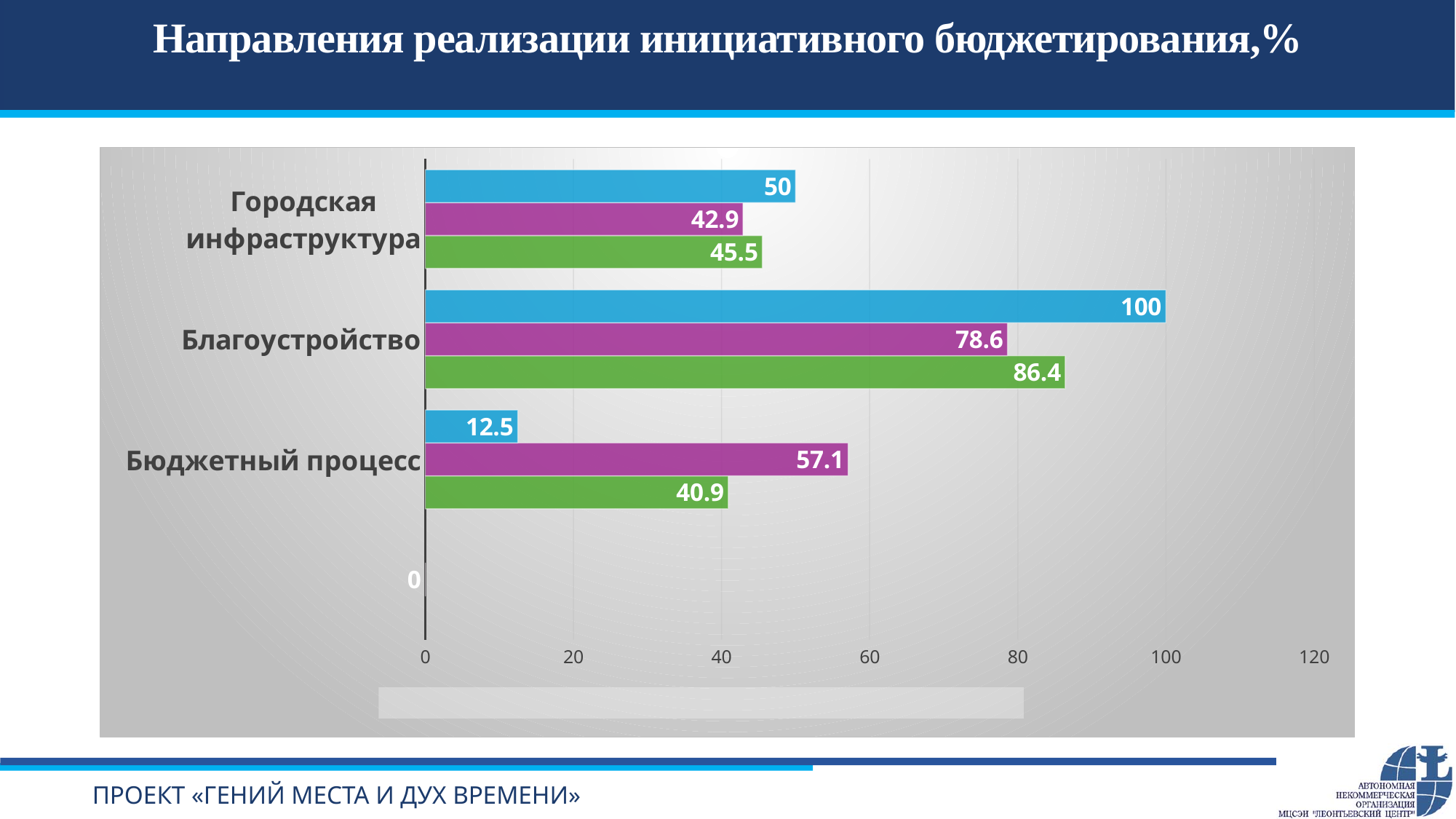
How many bars are shown for the category Городская инфраструктура? 3 What is the title of the chart on the slide? Направления реализации инициативного бюджетирования,% Which category has the lowest value for the blue bars? Бюджетный процесс What type of chart is shown on the slide? bar chart Which category has the highest value for the green bars? Благоустройство What is the value of the purple bar for Бюджетный процесс? 57.1 Is the value of the green bar for Благоустройство greater or less than 80? greater What is the value of the green bar for Городская инфраструктура? 45.5 What is the difference between the blue and purple bars for Благоустройство? 21.4 For Бюджетный процесс, which is larger: the purple bar or the green bar? the purple bar What is the value of the blue bar for Бюджетный процесс? 12.5 What is the value of the blue bar for Благоустройство? 100